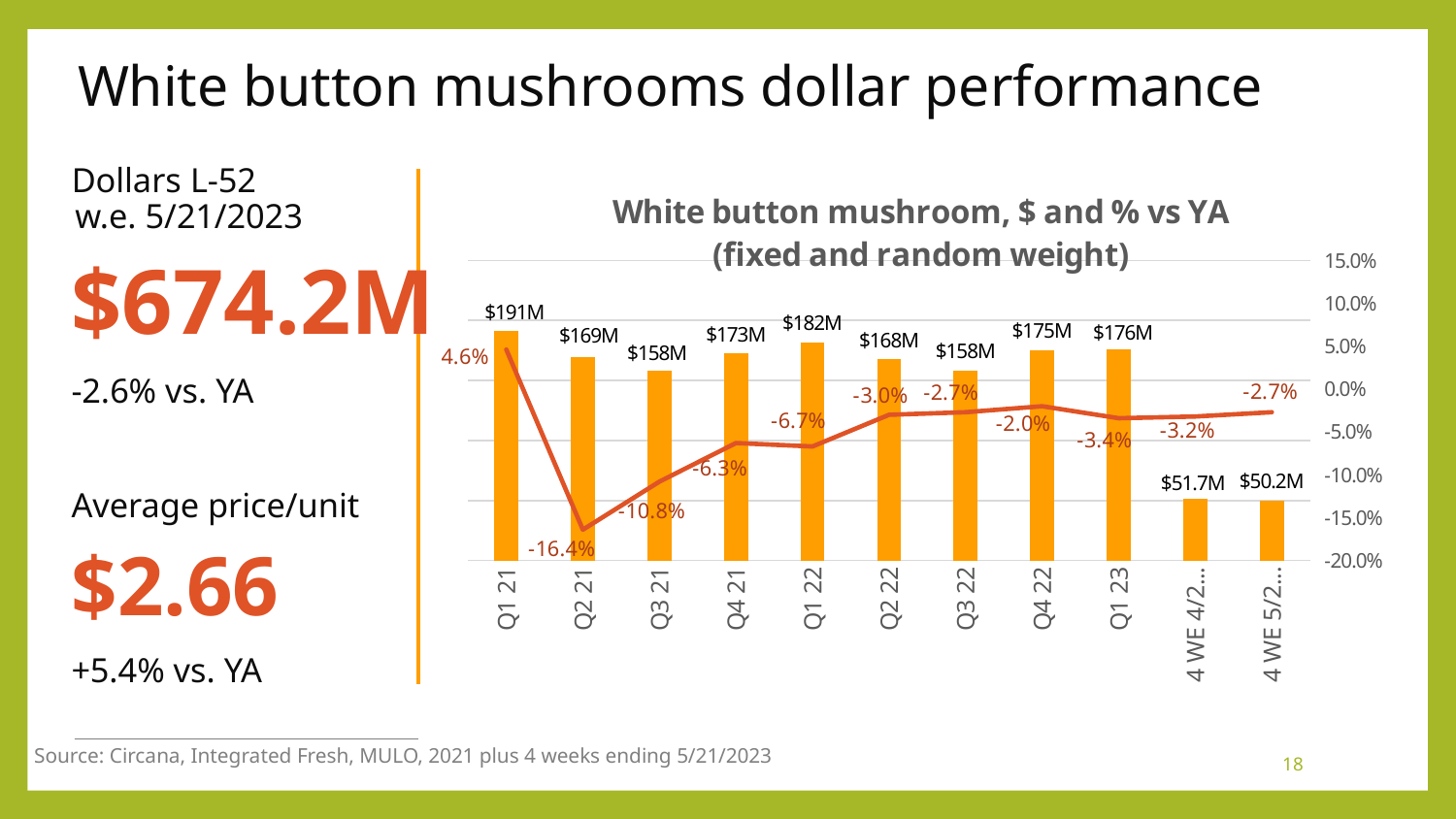
How many periods are shown on the x axis of the chart? 11 Which is larger, the dollar value for Q4 22 or for Q1 23? Q1 23 Is the % vs YA value for Q3 21 greater or less than -5.0%? less What is the % vs YA value shown for Q1 23? -3.4% What is the difference in dollars between Q1 21 and Q2 21? $22M What is the dollar value shown for Q1 21? $191M What kind of chart is shown on the slide? Combination bar and line chart What is the dollar value shown for Q1 22? $182M What is the title of the chart? White button mushroom, $ and % vs YA (fixed and random weight) Which period has the lowest % vs YA value on the line? Q2 21 Which quarter has the highest dollar value among the quarterly bars? Q1 21 What is the % vs YA value shown for Q2 21? -16.4%